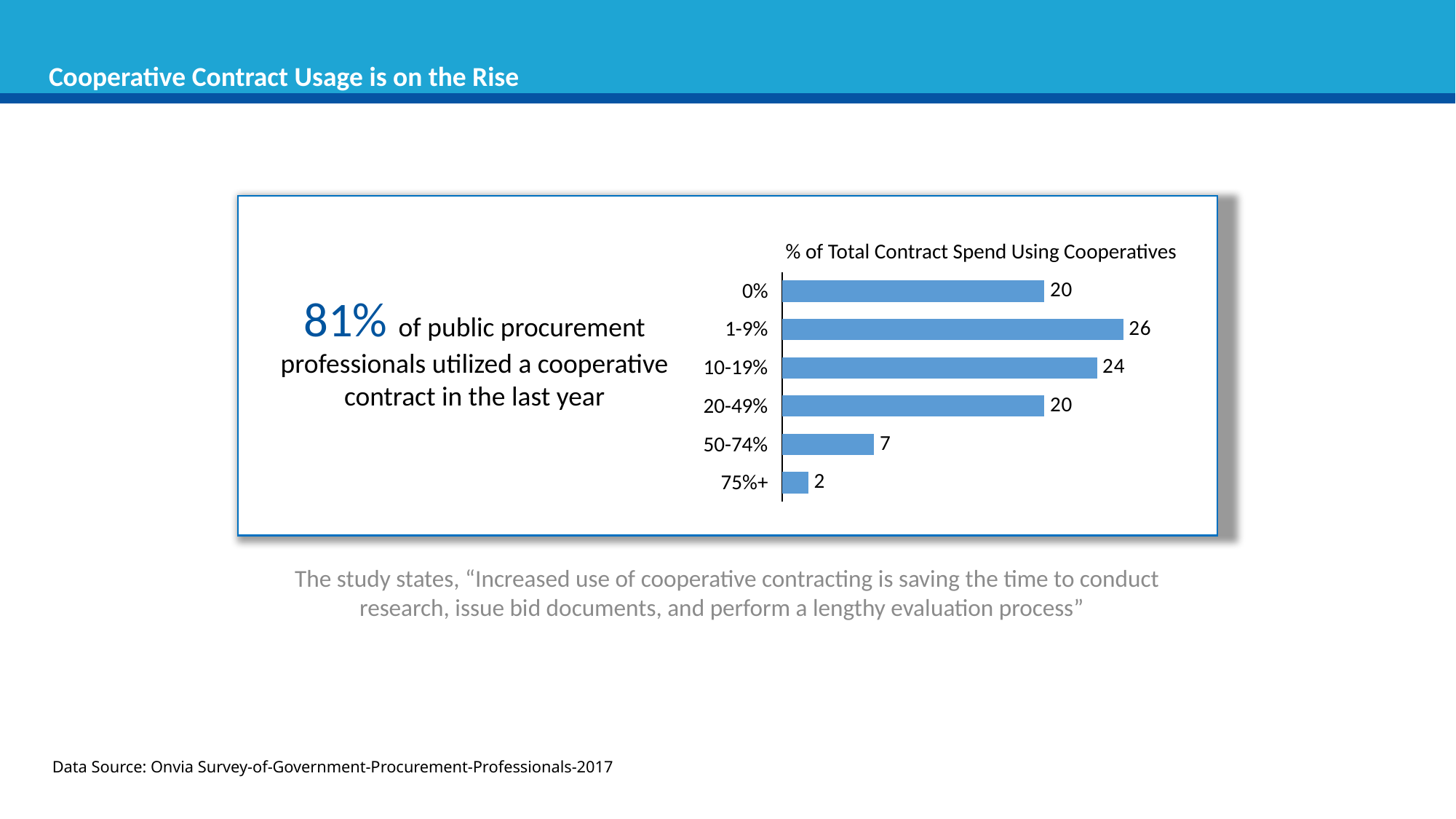
What is the value for the 75%+ category? 2 What is the title of the chart? % of Total Contract Spend Using Cooperatives Which category has the lowest value? 75%+ How many categories are shown in the chart? 6 What is the value for the 50-74% category? 7 What is the value for the 10-19% category? 24 What is the value for the 1-9% category? 26 What is the difference between the values for 1-9% and 10-19%? 2 What is the difference between the values for 20-49% and 50-74%? 13 Which is larger, the value for 0% or the value for 50-74%? 0% Which category has the highest value? 1-9% What kind of chart is shown on the slide? Bar chart